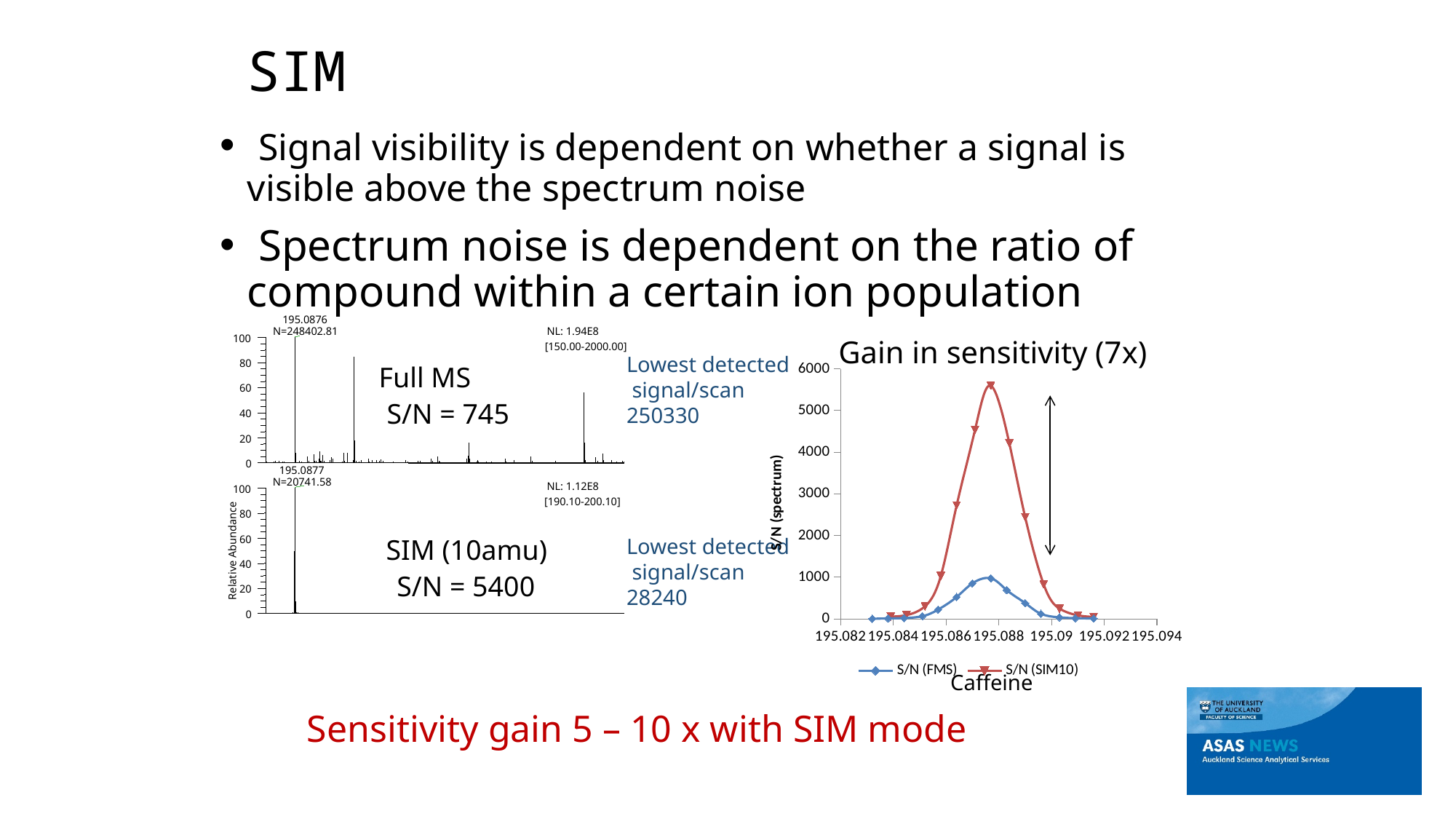
In the 'Gain in sensitivity (7x)' chart, which series reaches the higher peak, S/N (FMS) or S/N (SIM10)? S/N (SIM10) What S/N value is given for the SIM (10amu) spectrum on the left of the slide? 5400 In the 'Gain in sensitivity (7x)' chart, what is the highest value shown on the y axis? 6000 In the 'Gain in sensitivity (7x)' chart, is the peak value of the S/N (FMS) series greater or less than 2000? less What are the two series named in the legend of the 'Gain in sensitivity (7x)' chart? S/N (FMS) and S/N (SIM10) What kind of chart is the 'Gain in sensitivity (7x)' chart? line chart In the 'Gain in sensitivity (7x)' chart, is the peak value of the S/N (SIM10) series greater or less than 5000? greater What S/N value is given for the Full MS spectrum on the left of the slide? 745 In the 'Gain in sensitivity (7x)' chart, is the peak value of the S/N (SIM10) series greater or less than 6000? less How many series does the legend of the 'Gain in sensitivity (7x)' chart list? 2 What is the y-axis title of the 'Gain in sensitivity (7x)' chart? S/N (spectrum) In the 'Gain in sensitivity (7x)' chart, do the S/N (SIM10) values rise or fall between 195.084 and 195.088 on the x axis? rise